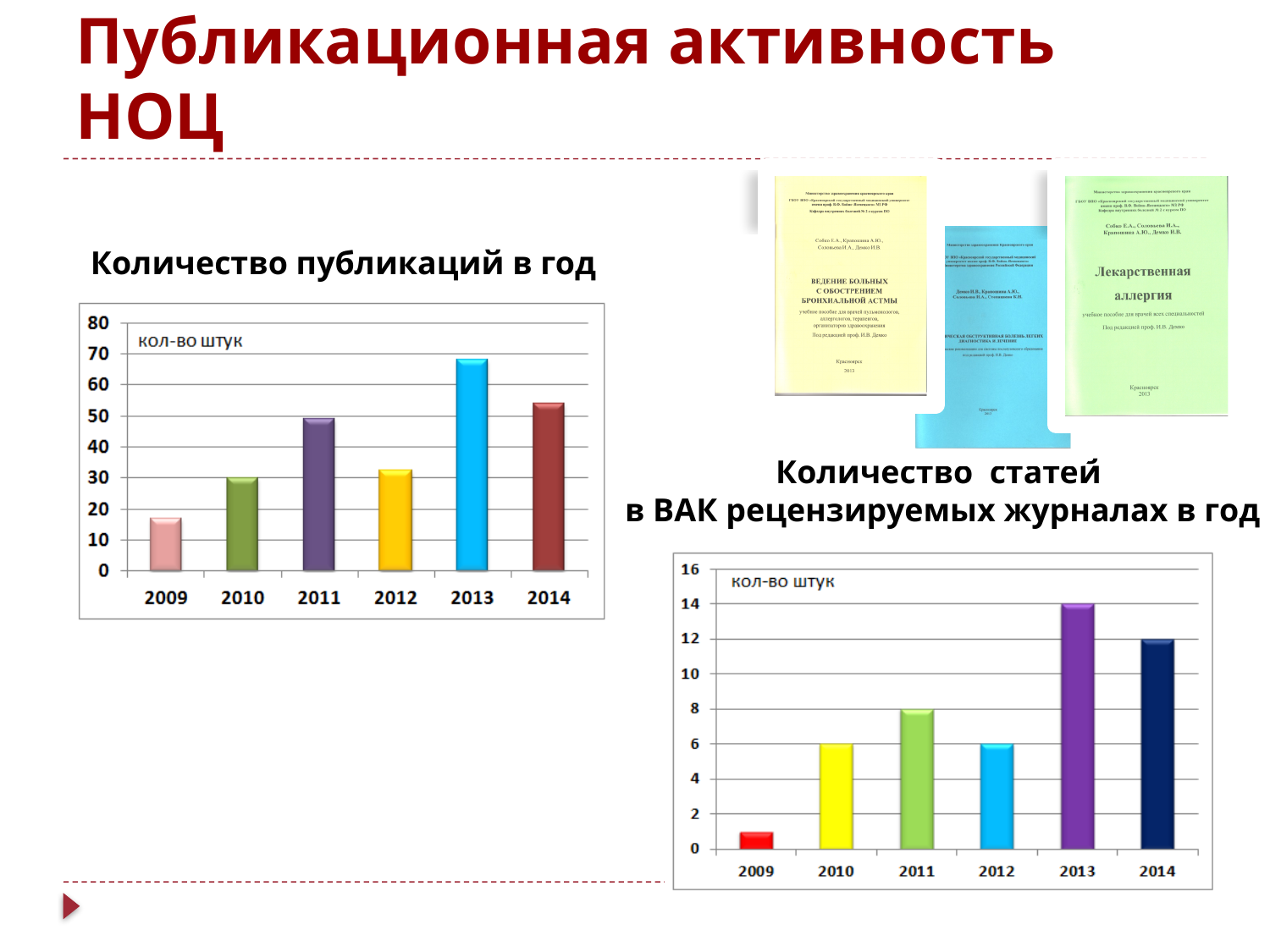
In the chart titled "Количество статей в ВАК рецензируемых журналах в год", what is the difference between the values for 2013 and 2014? 2 In the chart titled "Количество статей в ВАК рецензируемых журналах в год", what is the value for 2013? 14 In the chart titled "Количество публикаций в год", is the value for 2009 greater or less than 20? less What label appears inside the plot area of the chart titled "Количество статей в ВАК рецензируемых журналах в год"? кол-во штук What kind of chart is the chart titled "Количество публикаций в год"? bar chart How many years are shown on the x axis of the chart titled "Количество публикаций в год"? 6 In the chart titled "Количество публикаций в год", is the value for 2013 greater or less than 60? greater In the chart titled "Количество публикаций в год", which year has the lowest value? 2009 In the chart titled "Количество публикаций в год", which year has the highest value? 2013 In the chart titled "Количество статей в ВАК рецензируемых журналах в год", which year has the lowest value? 2009 In the chart titled "Количество статей в ВАК рецензируемых журналах в год", what is the value for 2014? 12 In the chart titled "Количество публикаций в год", which is larger, the value for 2011 or the value for 2012? 2011